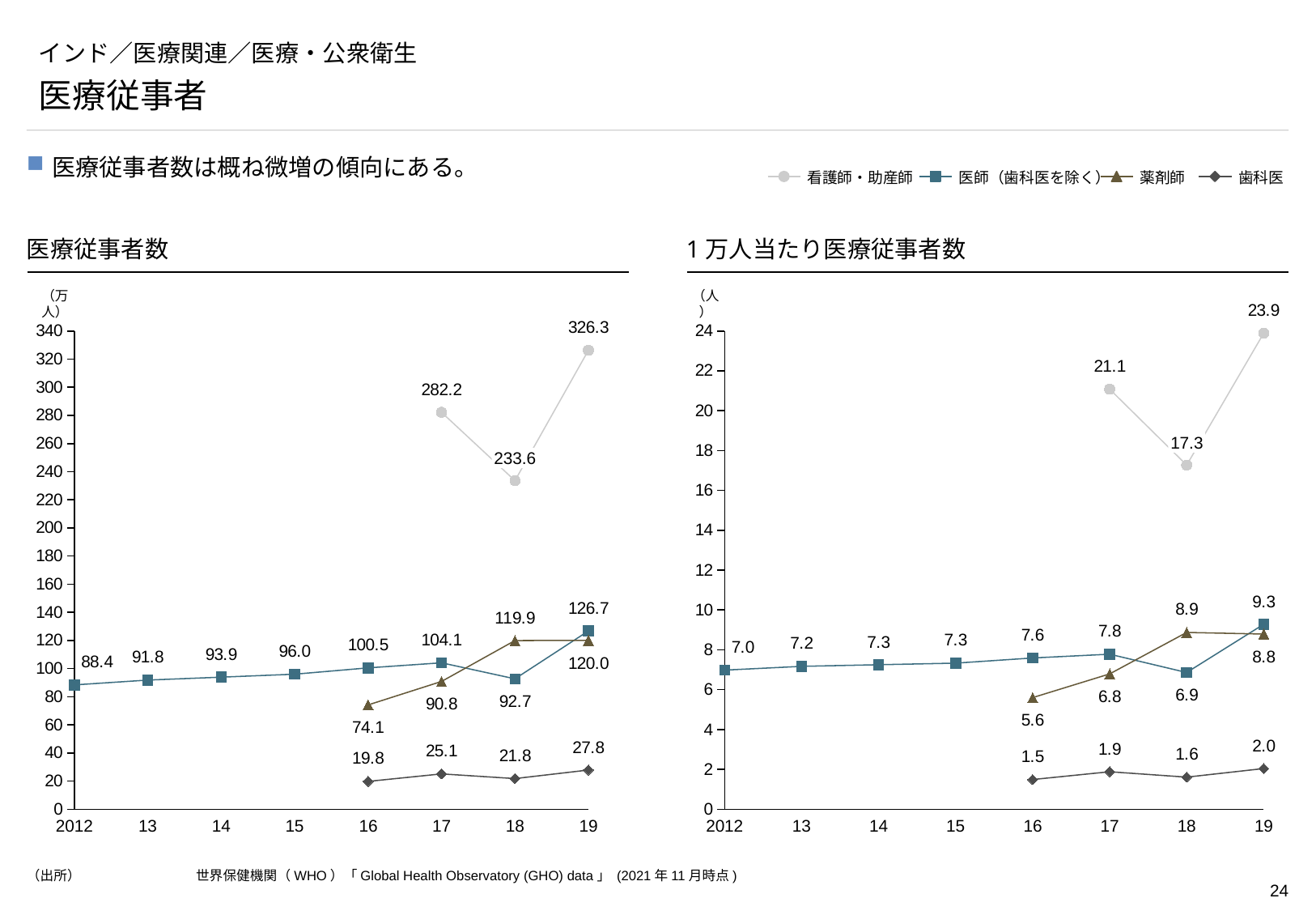
In the 医療従事者数 chart, in which year is the 看護師・助産師 value lowest? 18 In the 1万人当たり医療従事者数 chart, what is the value for 歯科医 in 2019? 2.0 In the 1万人当たり医療従事者数 chart, what is the difference between the 看護師・助産師 values in 2017 and 2018? 3.8 In the 医療従事者数 chart, does the 医師（歯科医を除く） series rise or fall from 2012 to 2017? Rise What kind of chart is the 1万人当たり医療従事者数 chart? Line chart In the 医療従事者数 chart, what is the value for 医師（歯科医を除く） in 2012? 88.4 In the 医療従事者数 chart, what is the value for 看護師・助産師 in 2019? 326.3 In the 1万人当たり医療従事者数 chart, in which year is the 医師（歯科医を除く） value highest? 19 In the 医療従事者数 chart, which is larger in 2018: 薬剤師 or 医師（歯科医を除く）? 薬剤師 How many series does the legend list? 4 In the 医療従事者数 chart, what is the difference between the 看護師・助産師 values in 2019 and 2018? 92.7 In the 1万人当たり医療従事者数 chart, what is the value for 薬剤師 in 2018? 8.9